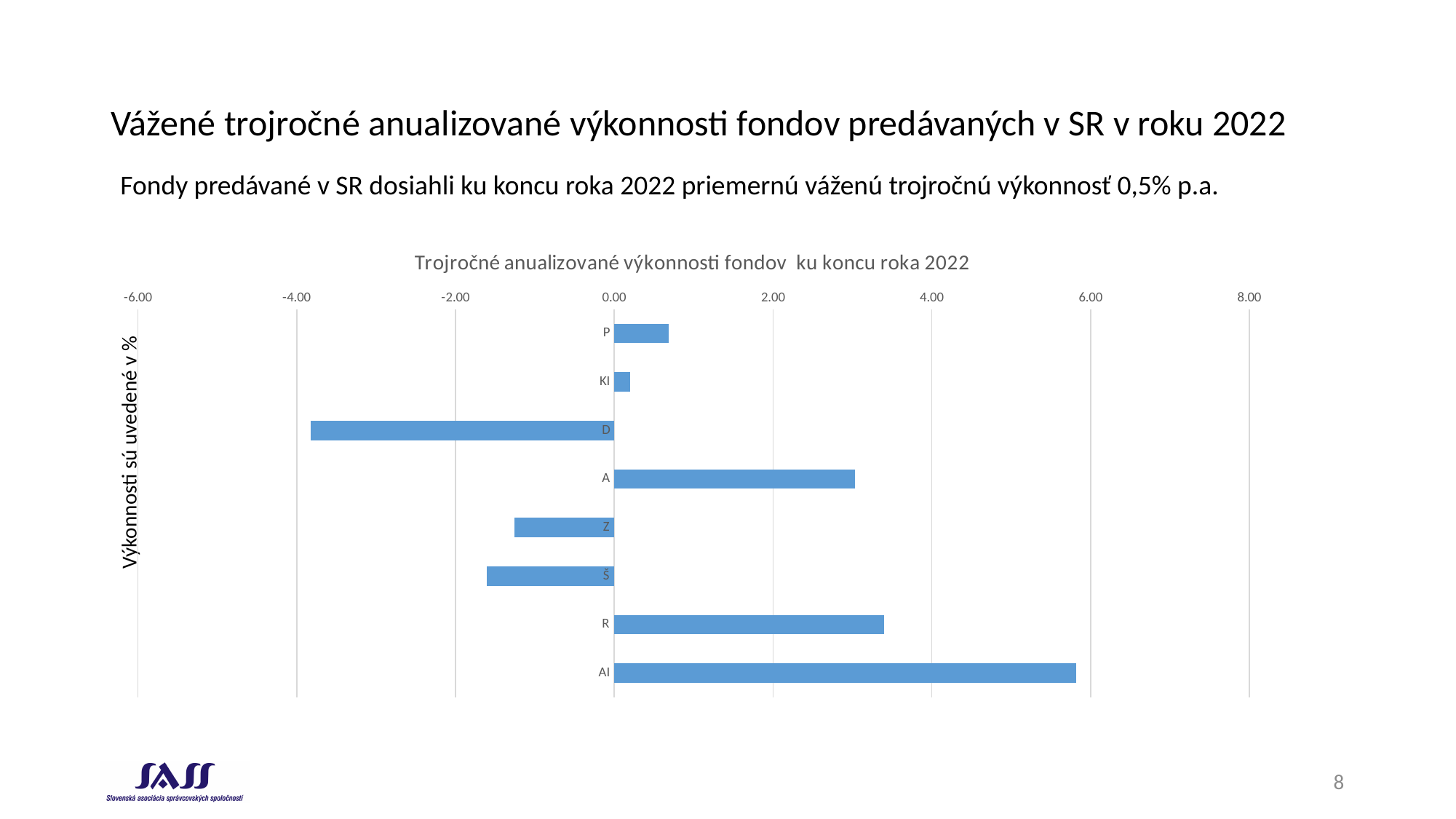
Is the value for R greater or less than 2.00? greater Is the value for Z greater or less than 0.00? less What kind of chart is shown on the slide? bar chart Which category has the lowest three-year annualized performance? D What is the title of the chart? Trojročné anualizované výkonnosti fondov ku koncu roka 2022 Is the value for P greater or less than 2.00? less Which category has the highest three-year annualized performance? AI Which has the larger value, AI or R? AI Which has the larger value, A or P? A How many fund categories are plotted in the chart? 8